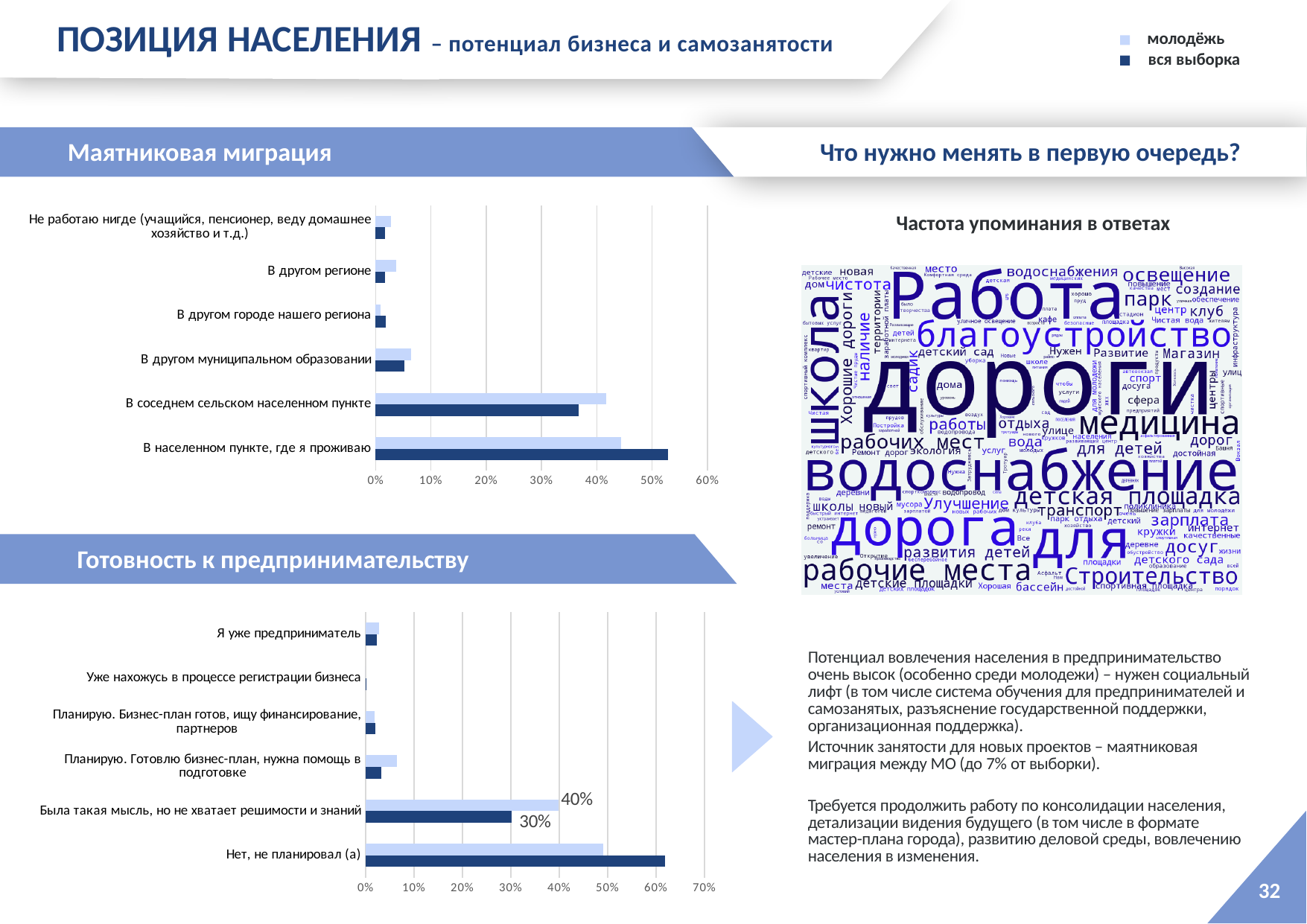
In the 'Готовность к предпринимательству' chart, which category has the highest value for 'вся выборка'? Нет, не планировал (а) In the 'Готовность к предпринимательству' chart, is the 'вся выборка' value for 'Нет, не планировал (а)' greater or less than 60%? greater In the 'Готовность к предпринимательству' chart, what is the difference between the 'молодёжь' and 'вся выборка' values for 'Была такая мысль, но не хватает решимости и знаний'? 10% In the 'Готовность к предпринимательству' chart, what is the 'вся выборка' value for 'Была такая мысль, но не хватает решимости и знаний'? 30% In the 'Маятниковая миграция' chart, for 'В соседнем сельском населенном пункте', which series has the larger value: 'молодёжь' or 'вся выборка'? молодёжь In the 'Готовность к предпринимательству' chart, what is the 'молодёжь' value for 'Была такая мысль, но не хватает решимости и знаний'? 40% What kind of chart is the 'Маятниковая миграция' chart? bar chart In the 'Маятниковая миграция' chart, is the 'вся выборка' value for 'В населенном пункте, где я проживаю' greater or less than 50%? greater How many categories does the 'Маятниковая миграция' chart show? 6 In the 'Маятниковая миграция' chart, is the 'молодёжь' value for 'В соседнем сельском населенном пункте' greater or less than 30%? greater How many series does the legend at the top right of the slide list? 2 In the 'Маятниковая миграция' chart, which category has the highest value for 'вся выборка'? В населенном пункте, где я проживаю